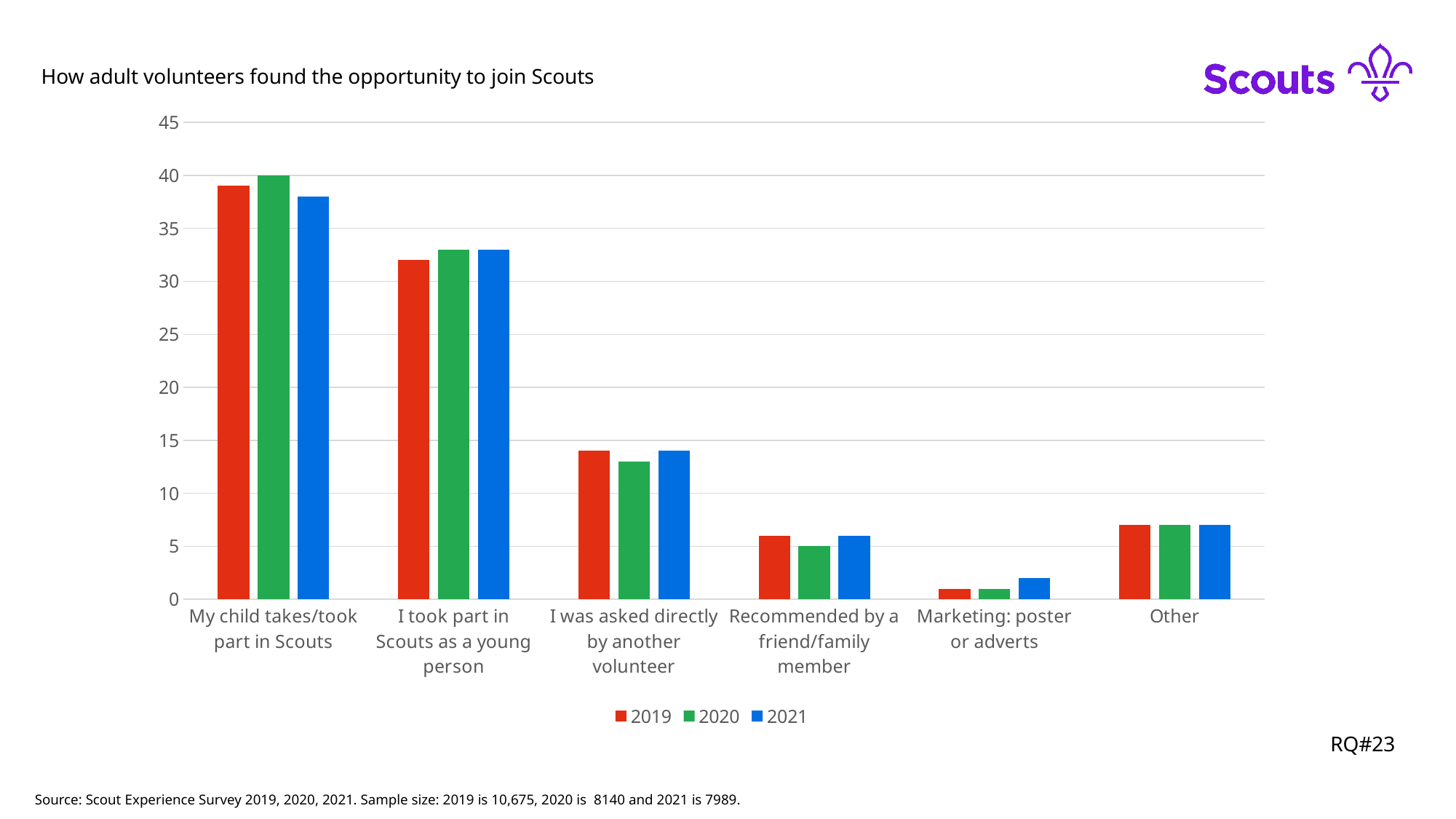
Which category has the lowest value for 2019? Marketing: poster or adverts Which is larger for 2019: 'My child takes/took part in Scouts' or 'I was asked directly by another volunteer'? My child takes/took part in Scouts Which category has the highest value for 2021? My child takes/took part in Scouts Is the value for 2021 in 'I took part in Scouts as a young person' greater or less than 30? greater Do the 2019 values rise or fall from 'My child takes/took part in Scouts' to 'Marketing: poster or adverts'? fall How many categories are shown on the x axis? 6 What kind of chart is shown on the slide? bar chart Is the value for 2021 in 'Marketing: poster or adverts' greater or less than 5? less What is the title of the chart? How adult volunteers found the opportunity to join Scouts What is the value for 2020 in the category 'My child takes/took part in Scouts'? 40 How many series does the legend list? 3 Is the value for 2019 in 'My child takes/took part in Scouts' greater or less than 35? greater